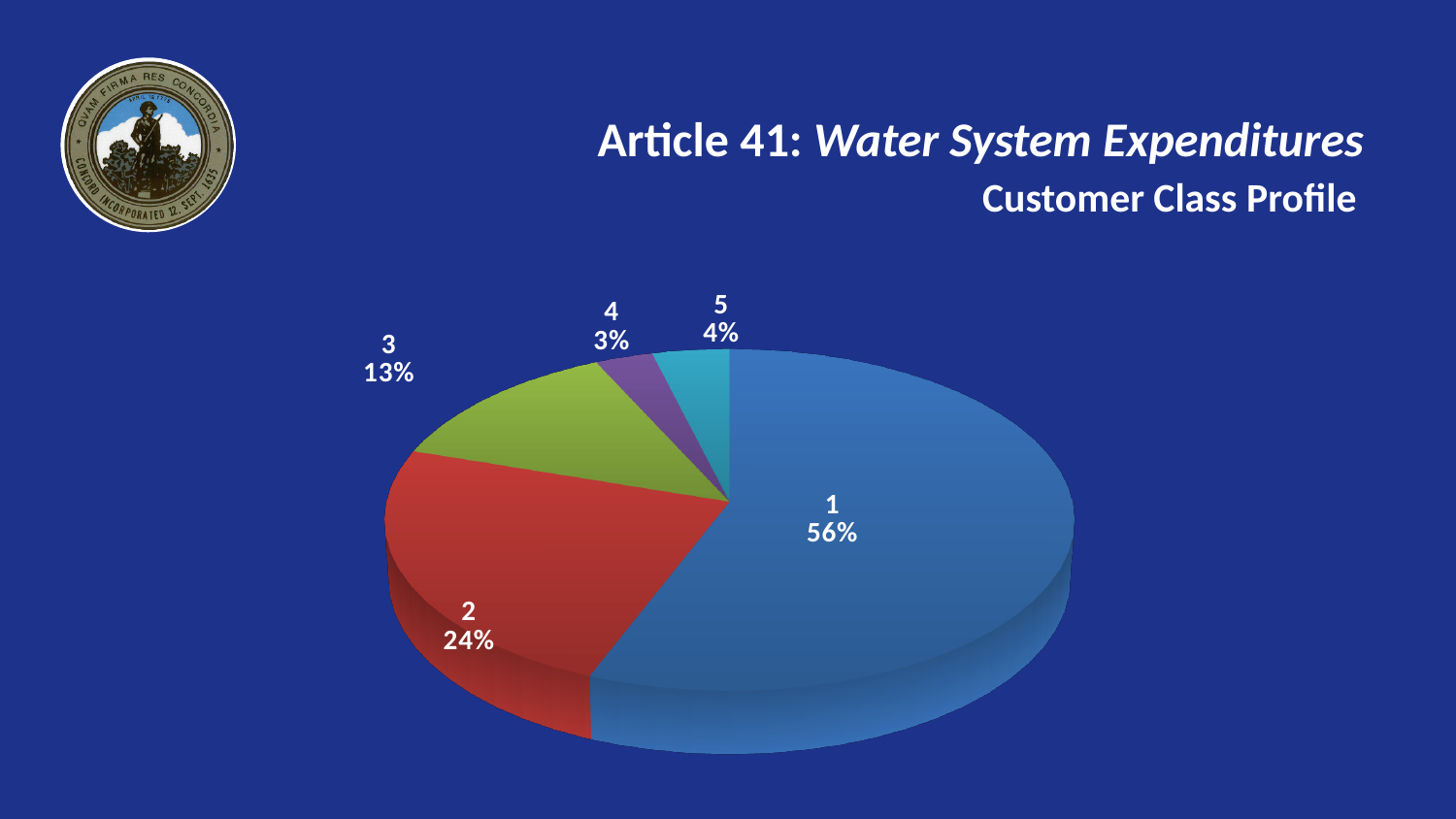
What is the value shown for category 5? 4% What is the value shown for category 4? 3% What is the difference in percentage points between category 1 and category 2? 32 Which category has the largest share of the pie? 1 What share of the pie does category 1 represent? 56% What kind of chart is shown on the slide? Pie chart How many slices does the pie chart have? 5 What colour is the slice for category 2? Red What share of the pie does category 2 represent? 24% Which is larger, the share for category 3 or the share for category 5? Category 3 Which category has the smallest share of the pie? 4 What is the value shown for category 3? 13%